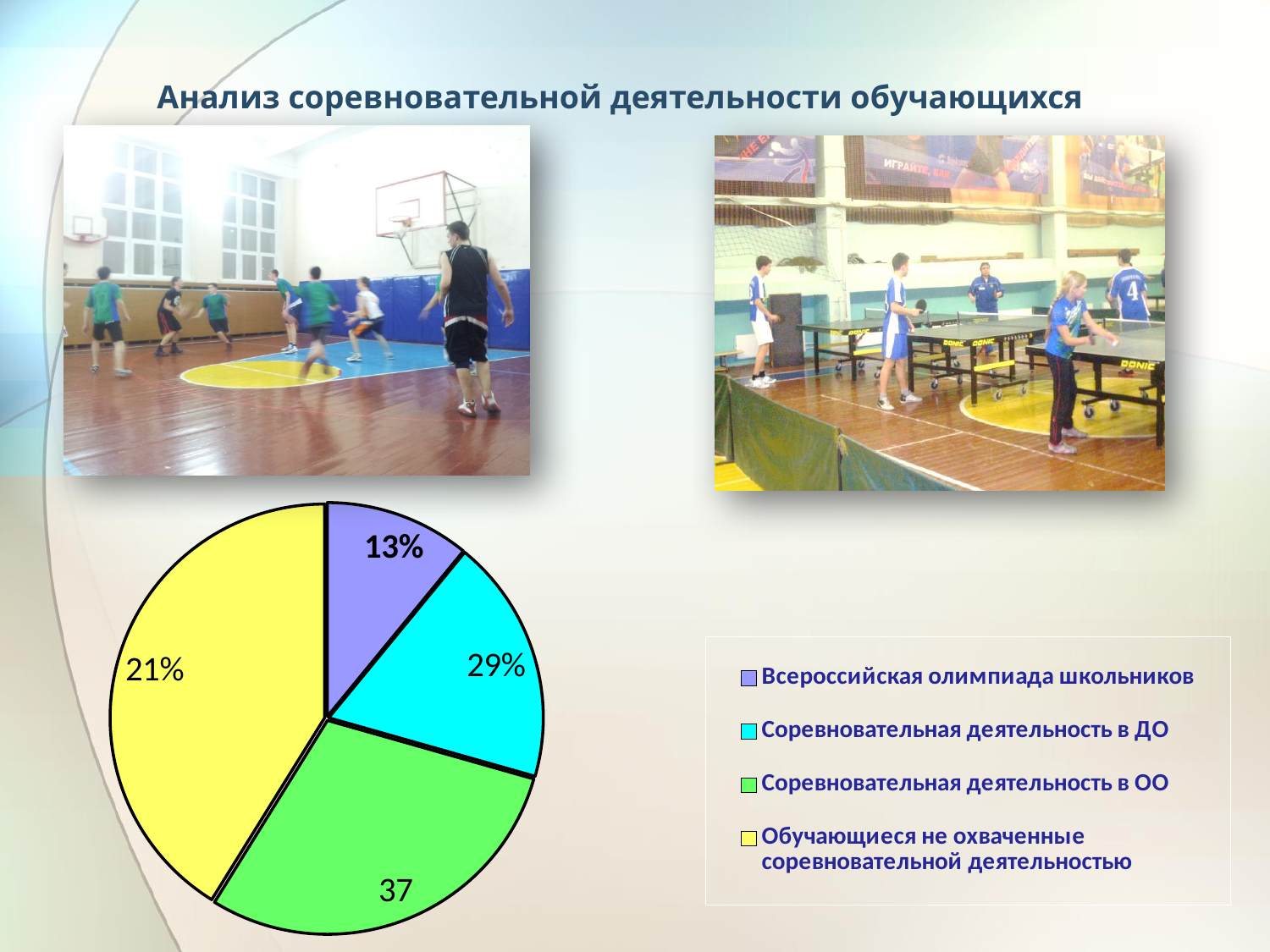
What value is printed on the purple slice (Всероссийская олимпиада школьников)? 13% What is the difference between the printed values for the cyan slice (29%) and the purple slice (13%)? 16% What colour represents 'Соревновательная деятельность в ОО' in the legend? green What value is printed on the green slice (Соревновательная деятельность в ОО)? 37 What colour represents 'Всероссийская олимпиада школьников' in the legend? purple What value is printed on the yellow slice (Обучающиеся не охваченные соревновательной деятельностью)? 21% What type of chart is shown on the slide? pie chart How many slices does the pie chart have? 4 How many entries does the legend of the pie chart list? 4 What value is printed on the cyan slice (Соревновательная деятельность в ДО)? 29% Which legend category corresponds to the smallest slice of the pie chart? Всероссийская олимпиада школьников